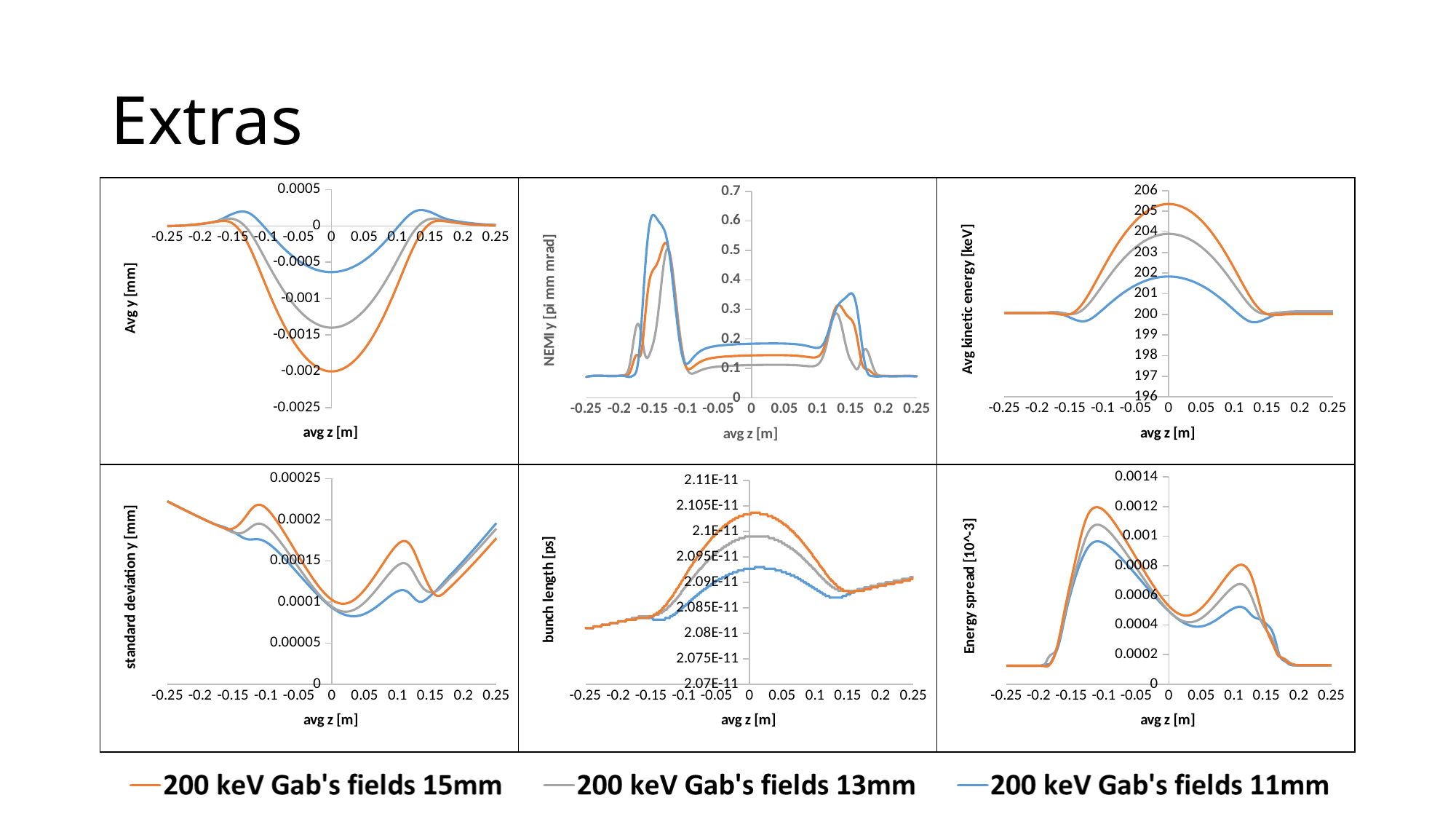
What is the x-axis label shared by all six charts? avg z [m] In the top-middle chart (NEMI y [pi mm mrad]), which series reaches the highest peak? 200 keV Gab's fields 11mm How many series does the legend at the bottom of the slide list? 3 In the bottom-right chart (Energy spread [10^-3]), is the highest peak of the 15mm series greater or less than 0.001? greater In the top-right chart (Avg kinetic energy [keV]), is the peak value of the 15mm series greater or less than 204? greater What kind of chart is the top-left chart with y-axis 'Avg y [mm]'? line chart In the top-left chart (Avg y [mm]), which series reaches the lowest minimum? 200 keV Gab's fields 15mm In the top-right chart (Avg kinetic energy [keV]), which series reaches the highest peak? 200 keV Gab's fields 15mm In the bottom-middle chart (bunch length [ps]), which series has the lowest peak? 200 keV Gab's fields 11mm How many charts are shown on the slide? 6 In the top-right chart (Avg kinetic energy [keV]), is the peak value of the 11mm series greater or less than 203? less In the bottom-right chart (Energy spread [10^-3]), which series has the higher first peak near avg z = -0.1: the 15mm series or the 11mm series? 200 keV Gab's fields 15mm